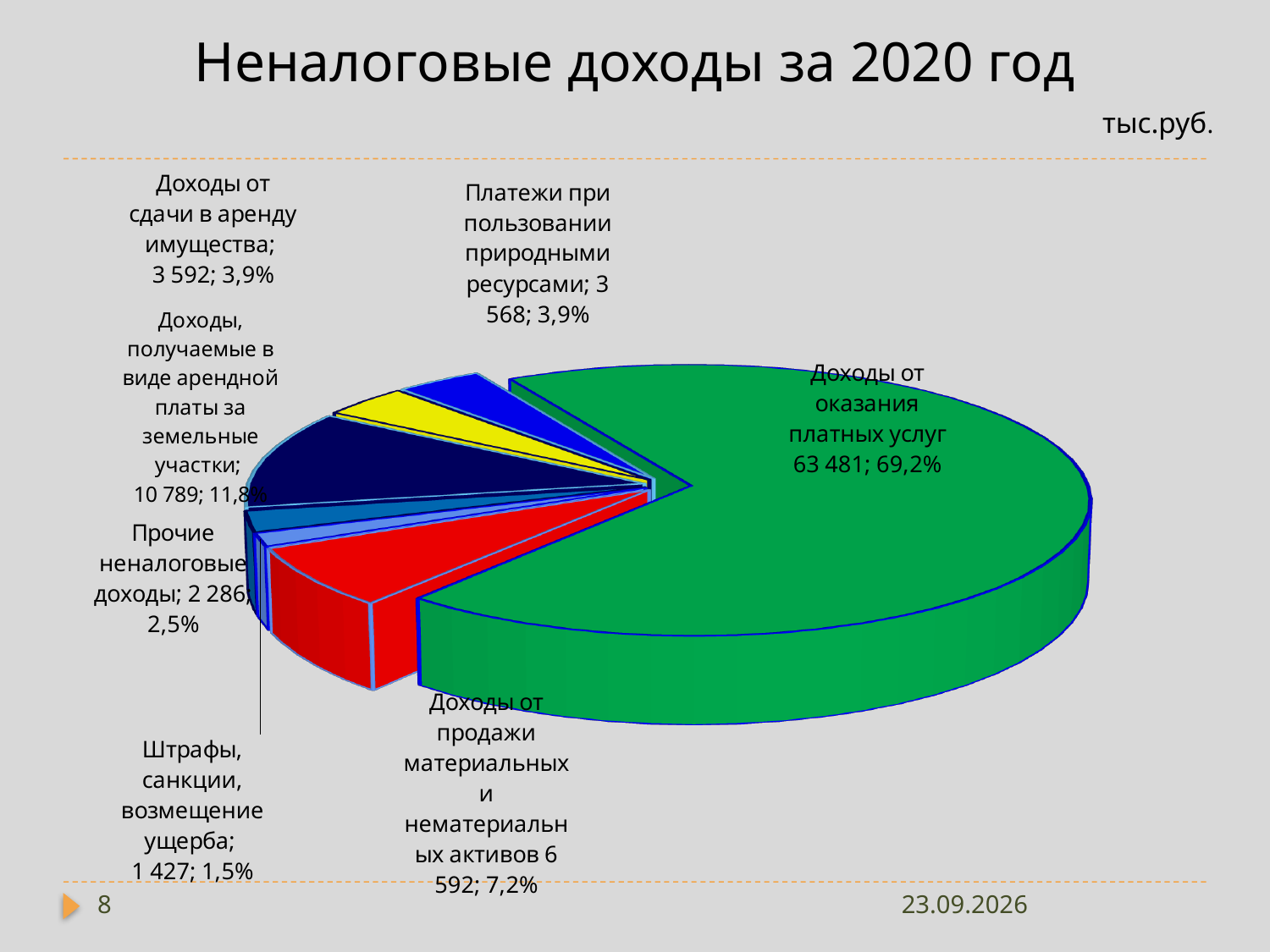
What is the value for «Доходы, получаемые в виде арендной платы за земельные участки»? 10 789 How many slices (categories) does the pie chart have? 7 What share of the pie does «Штрафы, санкции, возмещение ущерба» represent? 1,5% What kind of chart is shown on the slide? pie chart Which is larger: «Доходы от продажи материальных и нематериальных активов» or «Прочие неналоговые доходы»? Доходы от продажи материальных и нематериальных активов In what units are the values on the chart given? тыс.руб. What is the value for «Доходы от оказания платных услуг»? 63 481 What is the difference between the values for «Доходы от сдачи в аренду имущества» and «Платежи при пользовании природными ресурсами»? 24 What share of the pie does «Доходы от оказания платных услуг» represent? 69,2% Which category has the largest slice of the pie? Доходы от оказания платных услуг Which category has the smallest slice of the pie? Штрафы, санкции, возмещение ущерба What is the title of the chart on the slide? Неналоговые доходы за 2020 год